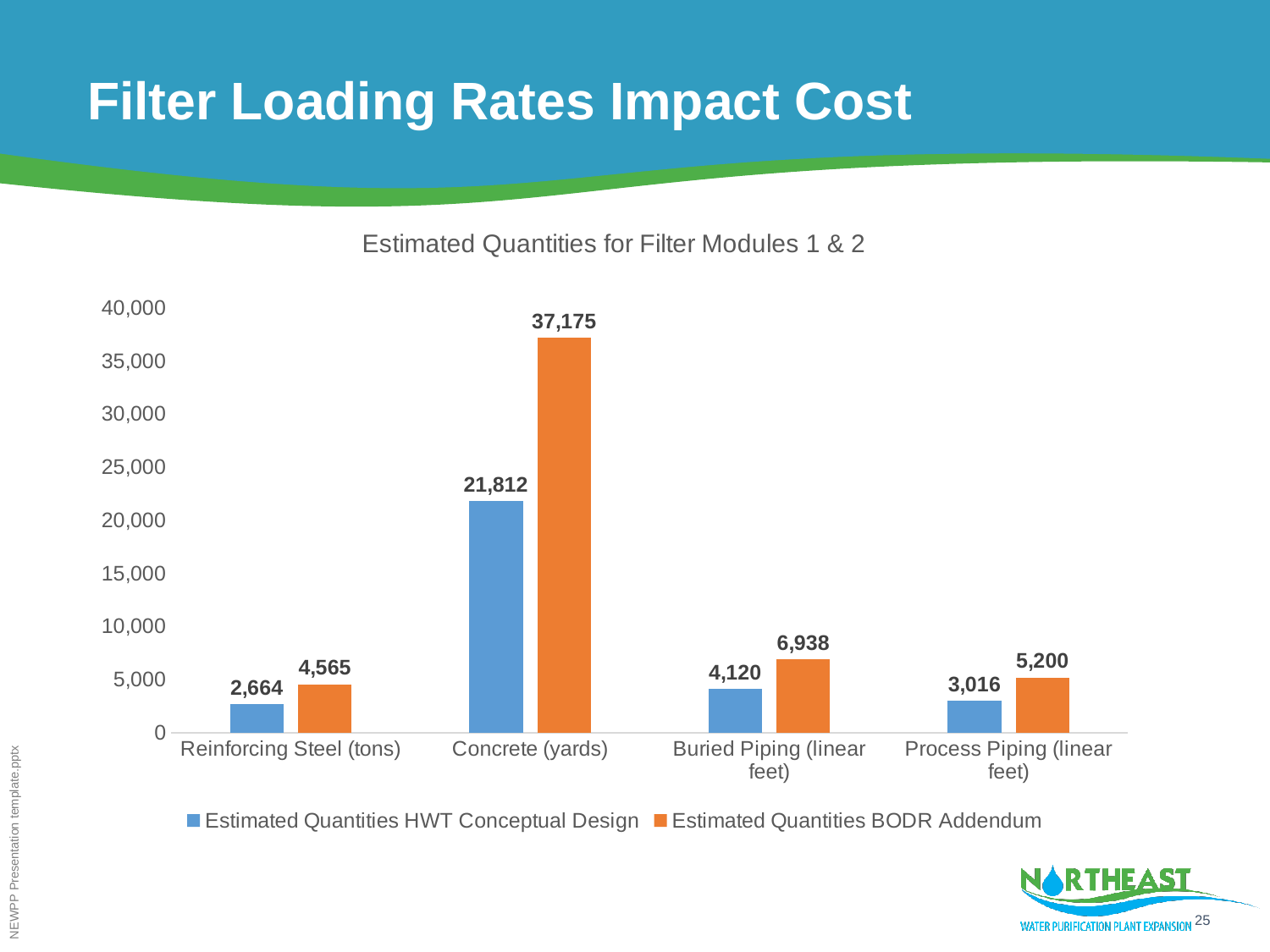
How many series does the legend list? 2 Which category has the lowest Estimated Quantities BODR Addendum value? Reinforcing Steel (tons) Is the Estimated Quantities HWT Conceptual Design value for Concrete (yards) greater or less than 20,000? greater What is the Estimated Quantities BODR Addendum value for Concrete (yards)? 37,175 Which is larger for Process Piping (linear feet): the HWT Conceptual Design value or the BODR Addendum value? Estimated Quantities BODR Addendum What kind of chart is shown on the slide? bar chart What is the Estimated Quantities HWT Conceptual Design value for Reinforcing Steel (tons)? 2,664 How many categories are shown on the x axis? 4 What is the difference between the BODR Addendum and HWT Conceptual Design values for Concrete (yards)? 15,363 What is the title of the chart? Estimated Quantities for Filter Modules 1 & 2 Which category has the highest Estimated Quantities HWT Conceptual Design value? Concrete (yards) What is the Estimated Quantities BODR Addendum value for Buried Piping (linear feet)? 6,938